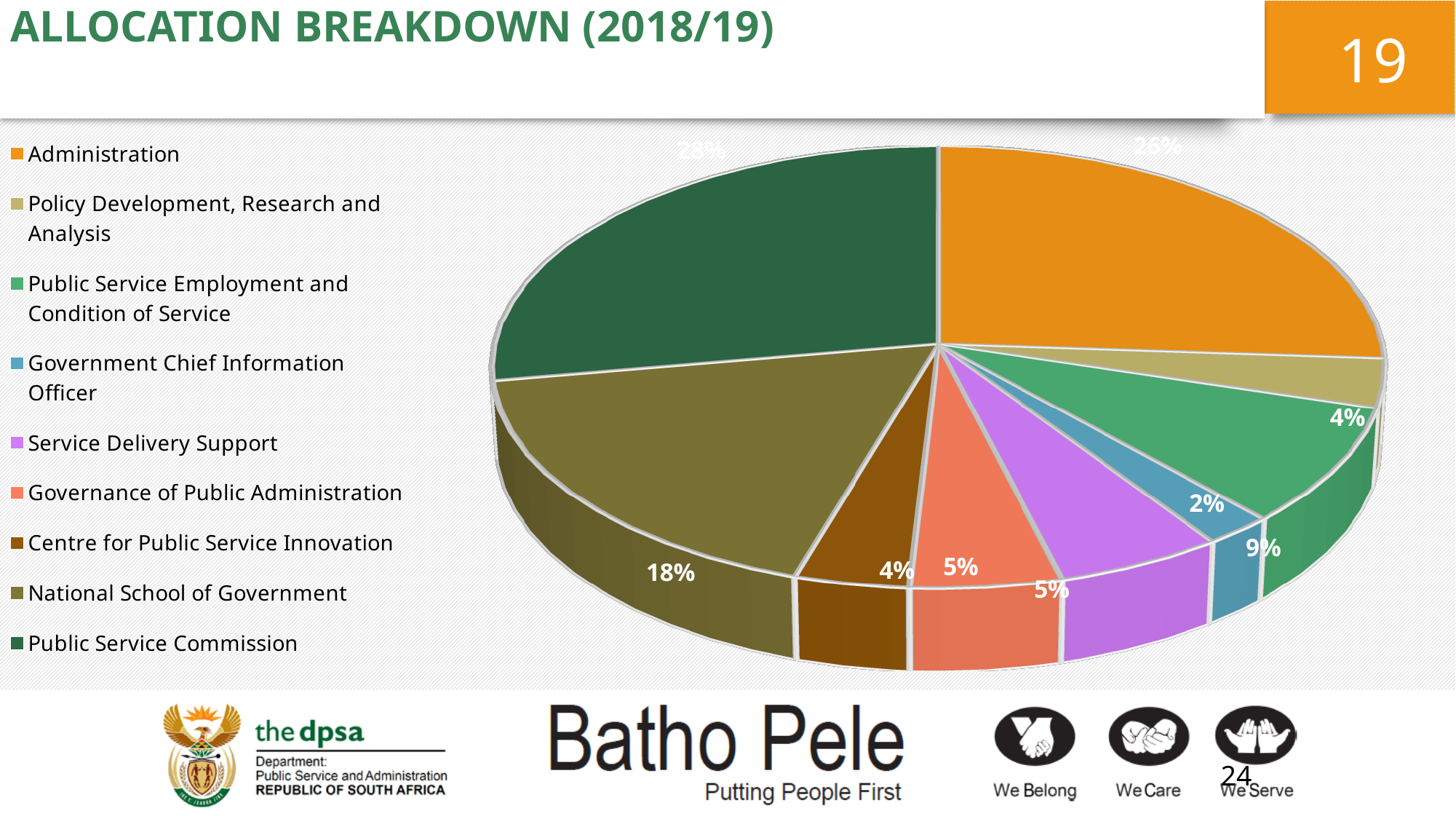
Which category receives the largest share of the allocation? Public Service Commission What percentage of the allocation goes to Public Service Employment and Condition of Service? 9% What percentage of the allocation goes to Administration? 26% What percentage of the allocation goes to the Government Chief Information Officer? 2% What kind of chart is shown on the slide? pie chart Which category receives the smallest share of the allocation? Government Chief Information Officer What percentage of the allocation goes to the National School of Government? 18% What is the title of the slide containing the chart? ALLOCATION BREAKDOWN (2018/19) How many percentage points larger is the Public Service Commission share than the Administration share? 2 What percentage of the allocation goes to the Public Service Commission? 28% How many categories are shown in the pie chart? 9 Which receives a larger share: National School of Government or Public Service Employment and Condition of Service? National School of Government